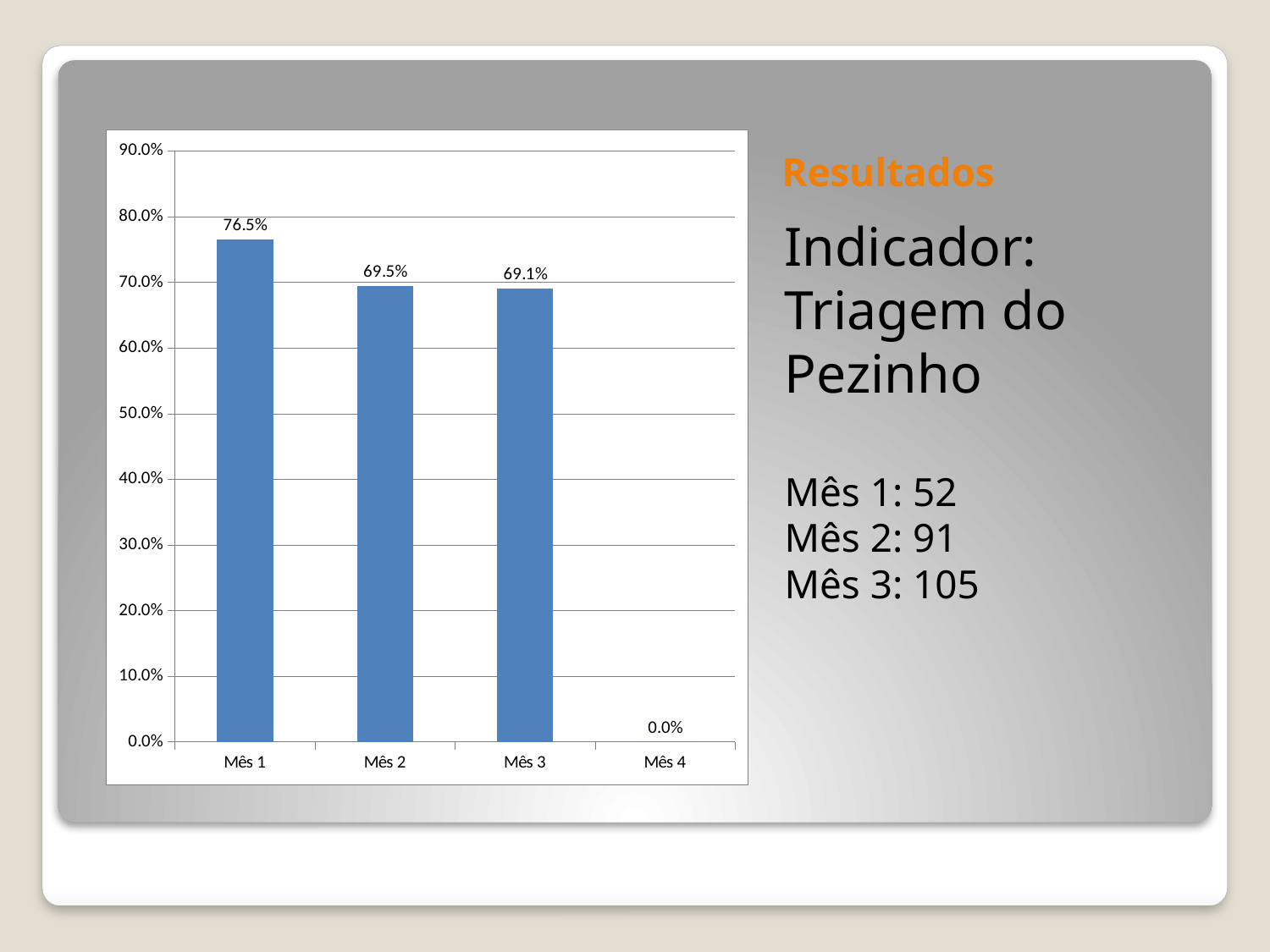
Which category has the lowest value? Mês 4 What kind of chart is shown on the slide? bar chart What is the value for Mês 4? 0.0% How many categories are shown on the x axis? 4 Which is larger, the value for Mês 1 or the value for Mês 3? Mês 1 What is the value for Mês 3? 69.1% Is the value for Mês 2 greater or less than 60.0%? greater What is the difference between the values for Mês 1 and Mês 2? 7.0% Which category has the highest value? Mês 1 What is the value for Mês 2? 69.5% Do the values rise or fall from Mês 1 to Mês 4? fall What is the value for Mês 1? 76.5%